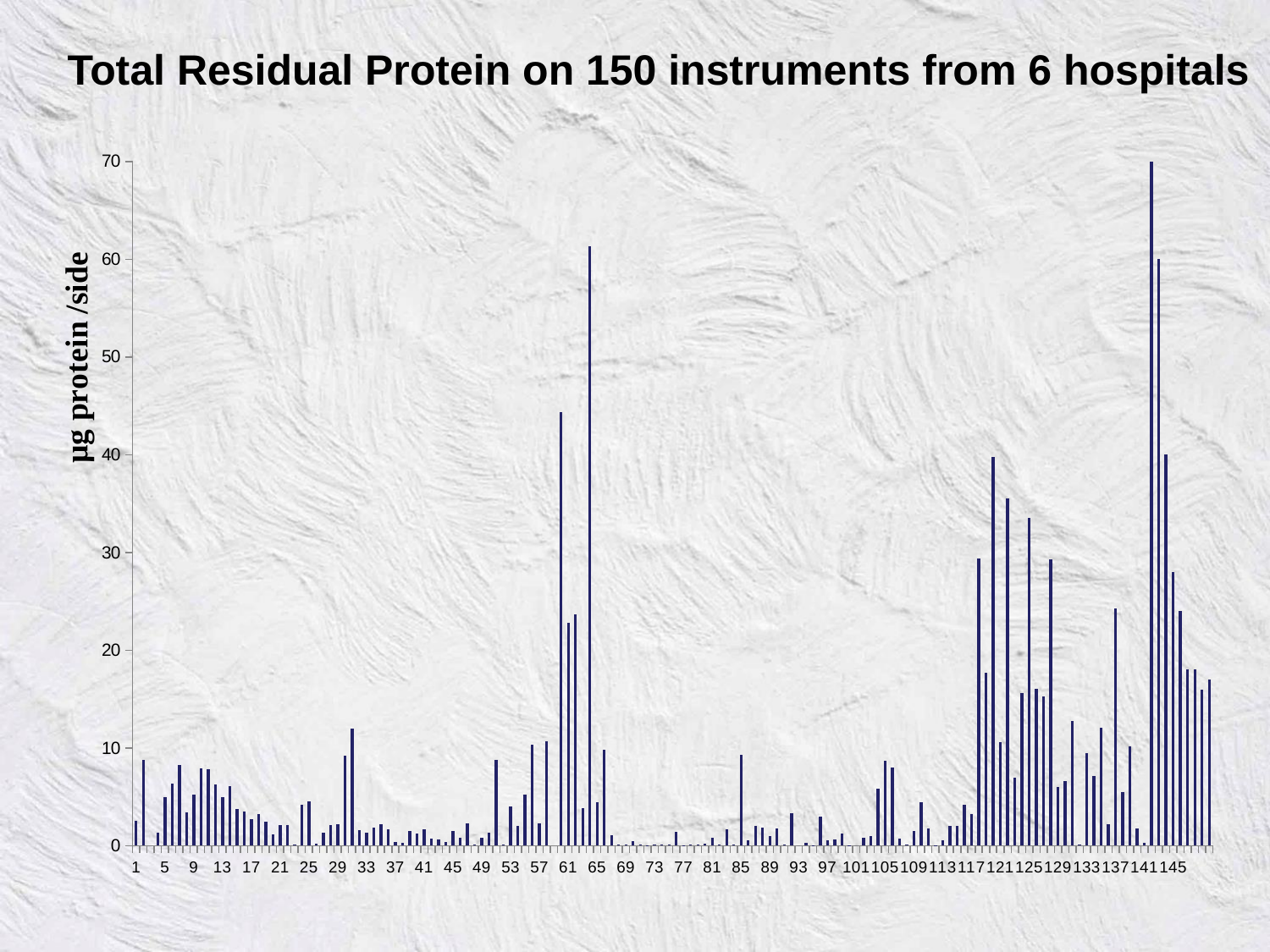
Which has the larger value, instrument 61 or instrument 1? instrument 61 Is the value for instrument 1 greater or less than 10? less Is the value for instrument 69 greater or less than 10? less Which has the larger value, instrument 145 or instrument 93? instrument 145 What is the title of the chart? Total Residual Protein on 150 instruments from 6 hospitals Is the value for instrument 93 greater or less than 10? less What is the label on the vertical axis of the chart? µg protein /side How many instruments (categories) are plotted on the chart? 150 What kind of chart is shown on the slide? bar chart